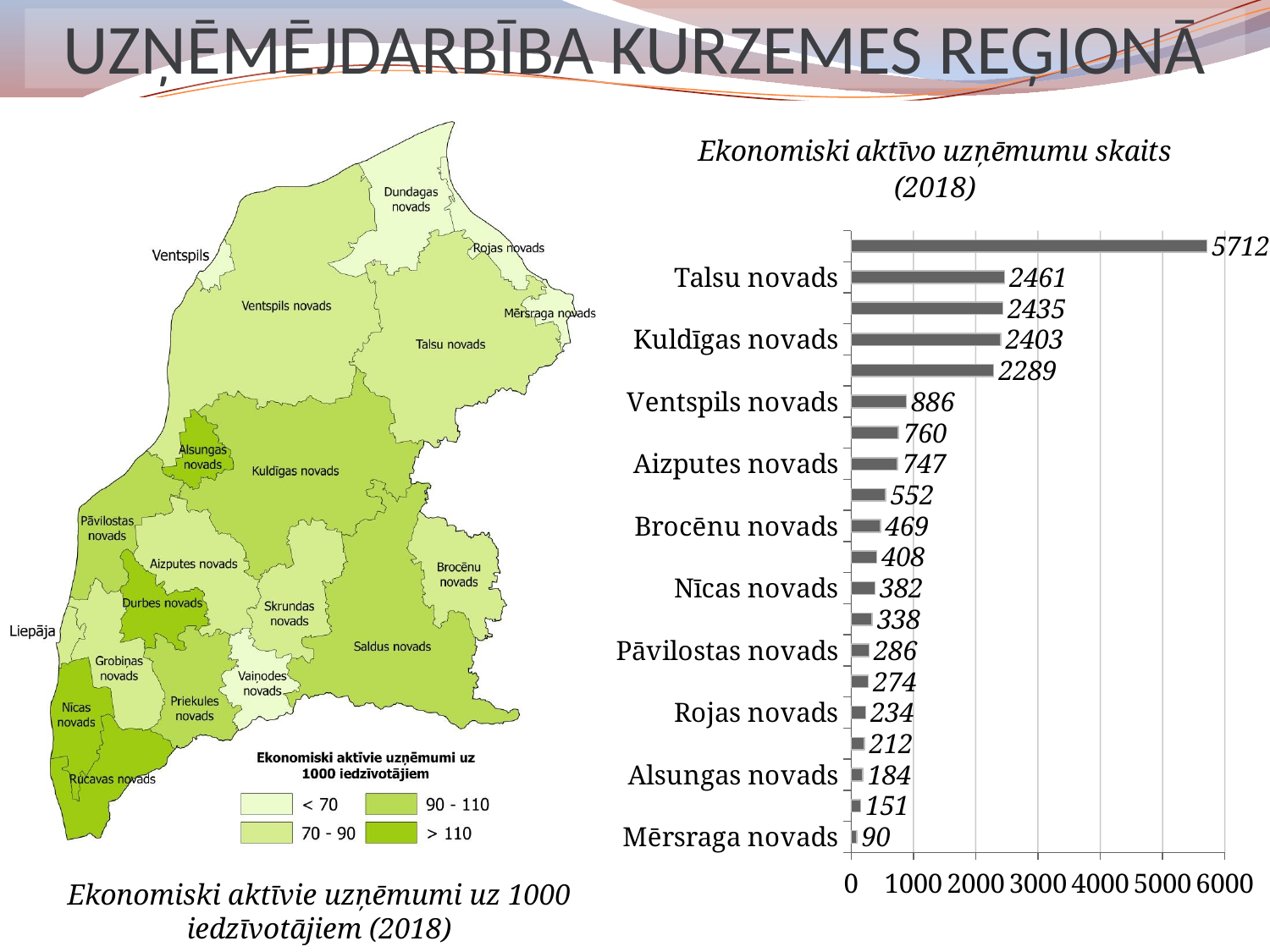
In the bar chart 'Ekonomiski aktīvo uzņēmumu skaits (2018)', what is the value for Rojas novads? 234 In the bar chart 'Ekonomiski aktīvo uzņēmumu skaits (2018)', what is the value for Talsu novads? 2461 In the bar chart 'Ekonomiski aktīvo uzņēmumu skaits (2018)', which labelled category has the lowest value? Mērsraga novads In the bar chart 'Ekonomiski aktīvo uzņēmumu skaits (2018)', what is the value for Ventspils novads? 886 In the bar chart 'Ekonomiski aktīvo uzņēmumu skaits (2018)', is the value for Ventspils novads greater or less than 1000? less In the bar chart 'Ekonomiski aktīvo uzņēmumu skaits (2018)', what is the difference between the values for Talsu novads and Kuldīgas novads? 58 In the bar chart 'Ekonomiski aktīvo uzņēmumu skaits (2018)', which is larger: the value for Aizputes novads or Brocēnu novads? Aizputes novads In the bar chart 'Ekonomiski aktīvo uzņēmumu skaits (2018)', what is the largest value shown on any bar? 5712 How many bars are plotted in the bar chart 'Ekonomiski aktīvo uzņēmumu skaits (2018)'? 20 What kind of chart is 'Ekonomiski aktīvo uzņēmumu skaits (2018)'? Bar chart In the bar chart 'Ekonomiski aktīvo uzņēmumu skaits (2018)', what is the value for Kuldīgas novads? 2403 In the bar chart 'Ekonomiski aktīvo uzņēmumu skaits (2018)', what is the value for Mērsraga novads? 90